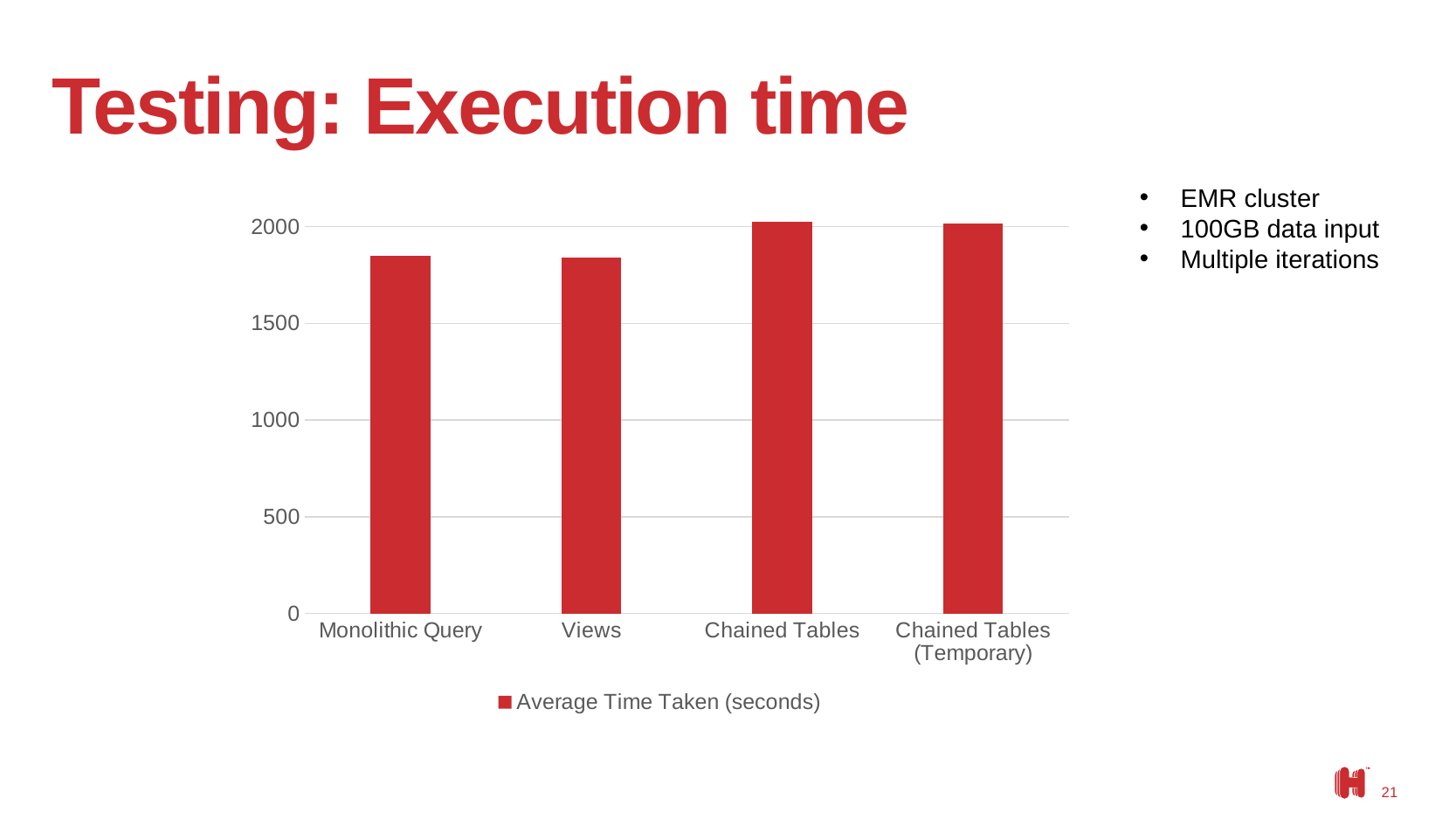
Is the value for Chained Tables (Temporary) greater or less than 1000? greater Is the value for Monolithic Query greater or less than 1500? greater Is the value for Views greater or less than 2000? less What colour are the bars in the chart? red Which has a larger value, Views or Chained Tables? Chained Tables How many series does the chart's legend list? 1 Which has a larger value, Monolithic Query or Chained Tables (Temporary)? Chained Tables (Temporary) What is the label of the first category on the x axis? Monolithic Query How many categories are shown on the x axis of the chart? 4 What is the name of the series shown in the chart's legend? Average Time Taken (seconds) What kind of chart is shown on the slide? bar chart